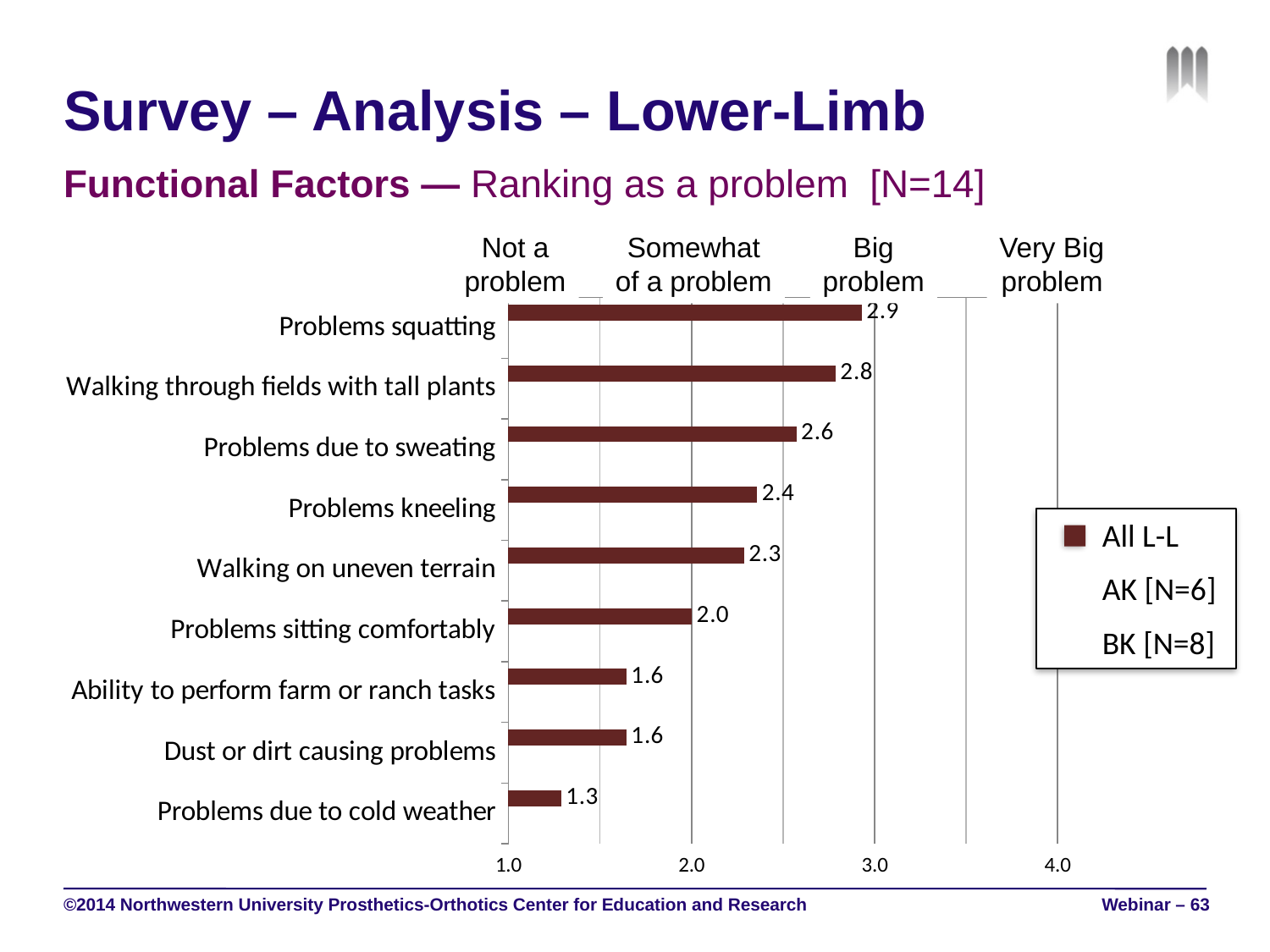
What is the difference between the values for Problems squatting and Problems due to cold weather? 1.6 Which category has the lowest value? Problems due to cold weather What is the value for Walking on uneven terrain? 2.3 What is the difference between the values for Problems due to sweating and Problems kneeling? 0.2 What is the value for Problems due to cold weather? 1.3 Which category has the highest value? Problems squatting How many categories are plotted in the chart? 9 What is the value for Problems sitting comfortably? 2.0 Which is larger, the value for Walking through fields with tall plants or the value for Problems kneeling? Walking through fields with tall plants What is the first entry listed in the chart's legend? All L-L What kind of chart is shown on the slide? Bar chart What is the value for Problems squatting? 2.9